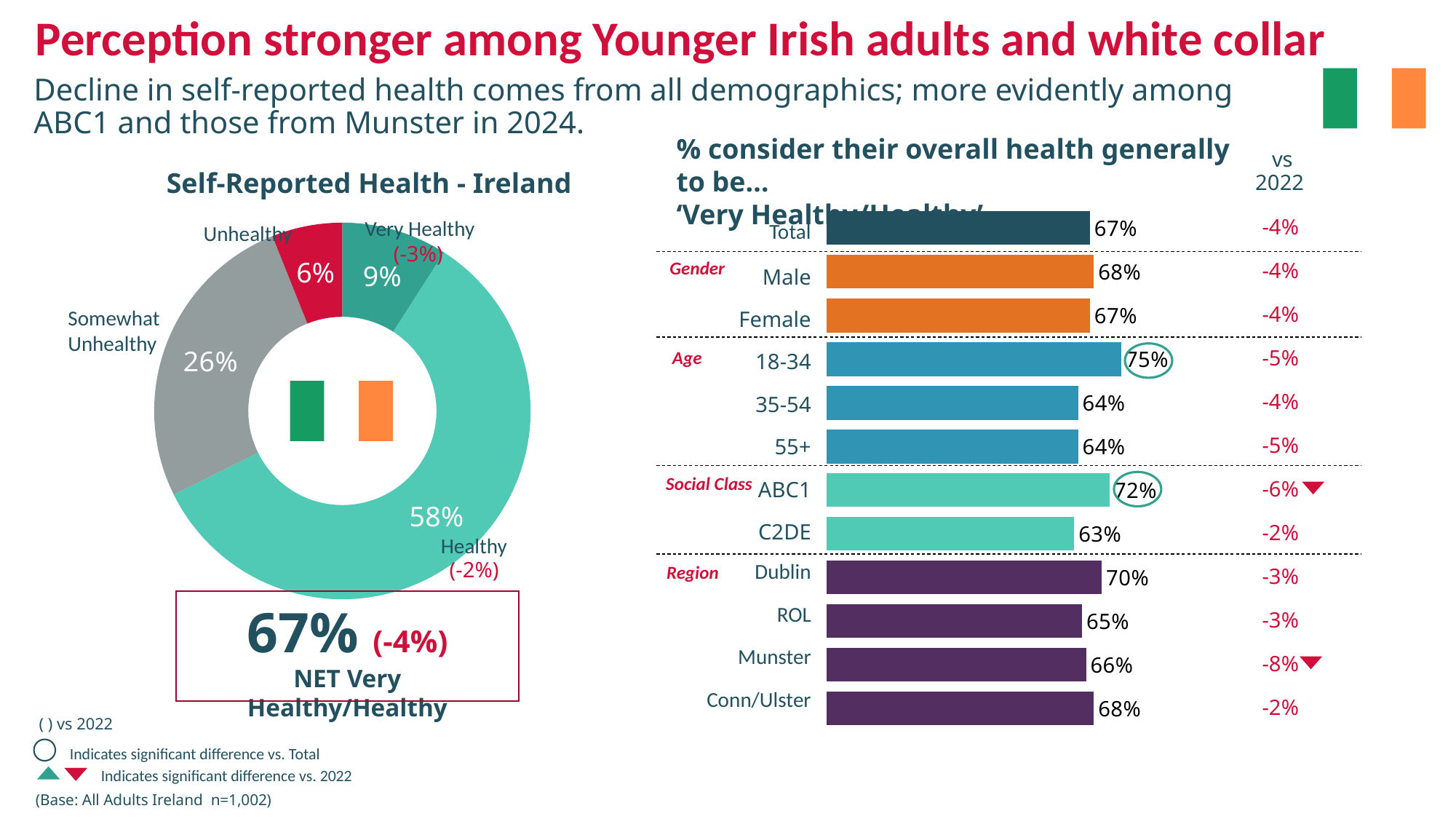
In the bar chart on the right, what is the 'vs 2022' change shown for Munster? -8% How many slices does the 'Self-Reported Health - Ireland' chart have? 4 What kind of chart is the 'Self-Reported Health - Ireland' chart? Pie (donut) chart In the 'Self-Reported Health - Ireland' chart, what is the combined share of Very Healthy and Healthy? 67% In the 'Self-Reported Health - Ireland' chart, which category has the smallest share? Unhealthy In the 'Self-Reported Health - Ireland' chart, which category has the largest share? Healthy In the 'Self-Reported Health - Ireland' chart, what percentage is shown for Healthy? 58% In the bar chart on the right, what percentage of 18-34 year olds consider their health Very Healthy/Healthy? 75% In the bar chart on the right, which group has the highest percentage? 18-34 In the bar chart on the right, which is higher, ABC1 or C2DE? ABC1 In the bar chart on the right, which group has the lowest percentage? C2DE In the bar chart on the right, what is the difference between Dublin and ROL? 5 percentage points